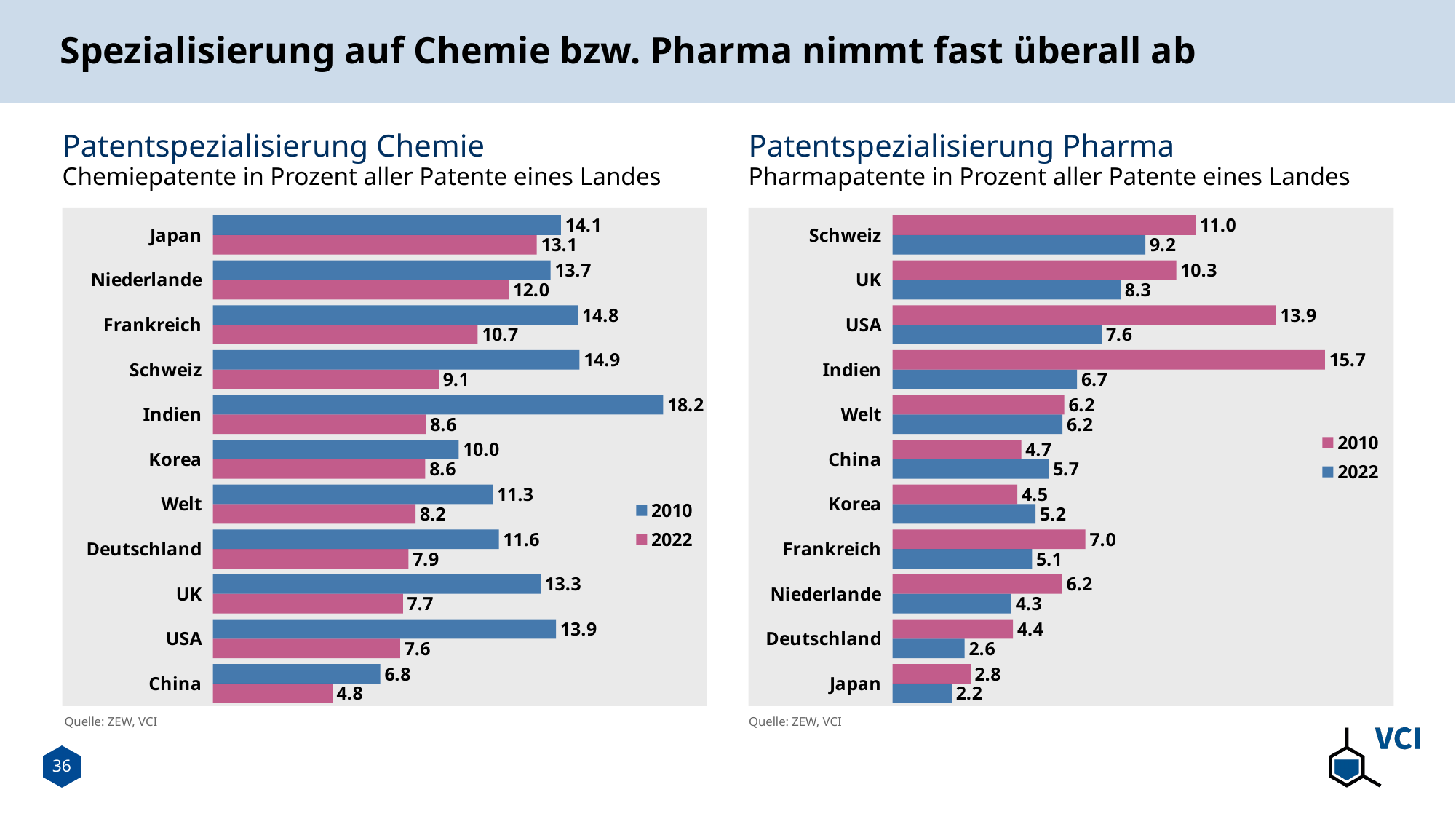
In the Patentspezialisierung Chemie chart, what is the value for Deutschland in 2022? 7.9 In the Patentspezialisierung Chemie chart, how many countries or regions are listed? 11 What kind of chart is the Patentspezialisierung Pharma chart? Bar chart In the Patentspezialisierung Pharma chart, what is the value for Indien in 2010? 15.7 In the Patentspezialisierung Pharma chart, what is the value for Japan in 2022? 2.2 In the Patentspezialisierung Chemie chart, what is the value for Indien in 2010? 18.2 In the Patentspezialisierung Chemie chart, what is the difference between the 2010 and 2022 values for Schweiz? 5.8 In the Patentspezialisierung Chemie chart, which country has the highest 2010 value? Indien In the Patentspezialisierung Chemie chart, which country has the lowest 2022 value? China In the Patentspezialisierung Pharma chart, what is the difference between the 2010 and 2022 values for USA? 6.3 In the Patentspezialisierung Pharma chart, how many series does the legend list? 2 In the Patentspezialisierung Pharma chart, which is larger for China: the 2010 value or the 2022 value? 2022